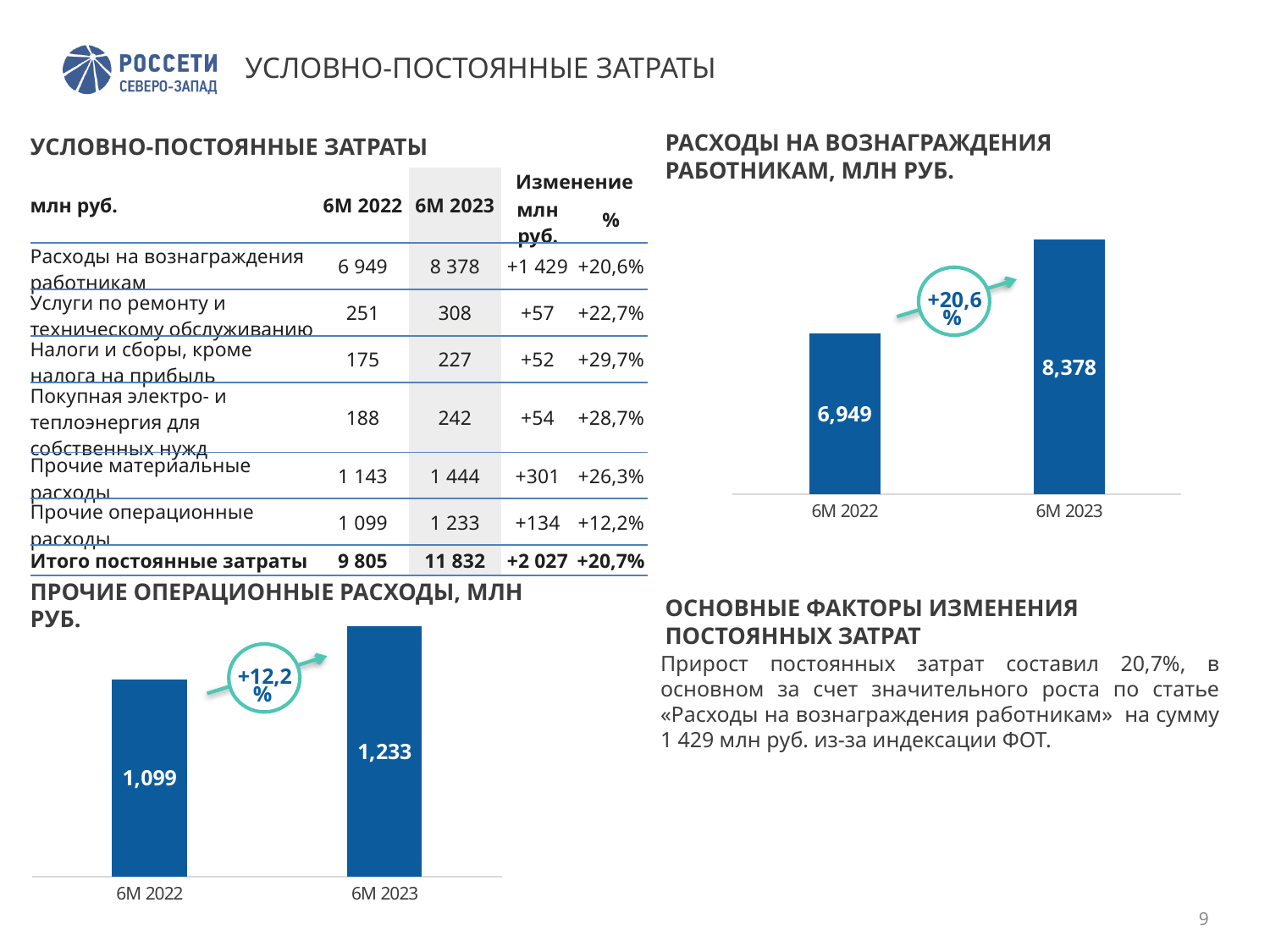
In the chart 'ПРОЧИЕ ОПЕРАЦИОННЫЕ РАСХОДЫ, МЛН РУБ.', what is the value for 6M 2023? 1,233 In the chart 'РАСХОДЫ НА ВОЗНАГРАЖДЕНИЯ РАБОТНИКАМ, МЛН РУБ.', what is the value for 6M 2023? 8,378 In the chart 'ПРОЧИЕ ОПЕРАЦИОННЫЕ РАСХОДЫ, МЛН РУБ.', do the values rise or fall from 6M 2022 to 6M 2023? Rise In the chart 'РАСХОДЫ НА ВОЗНАГРАЖДЕНИЯ РАБОТНИКАМ, МЛН РУБ.', what is the value for 6M 2022? 6,949 In the chart 'ПРОЧИЕ ОПЕРАЦИОННЫЕ РАСХОДЫ, МЛН РУБ.', how many bars are plotted? 2 In the chart 'РАСХОДЫ НА ВОЗНАГРАЖДЕНИЯ РАБОТНИКАМ, МЛН РУБ.', what is the difference between the 6M 2023 and 6M 2022 values? 1,429 In the chart 'РАСХОДЫ НА ВОЗНАГРАЖДЕНИЯ РАБОТНИКАМ, МЛН РУБ.', what percentage change is shown between 6M 2022 and 6M 2023? +20,6% In the chart 'ПРОЧИЕ ОПЕРАЦИОННЫЕ РАСХОДЫ, МЛН РУБ.', which period has the lower value? 6M 2022 What type of chart is 'РАСХОДЫ НА ВОЗНАГРАЖДЕНИЯ РАБОТНИКАМ, МЛН РУБ.'? Bar chart In the chart 'РАСХОДЫ НА ВОЗНАГРАЖДЕНИЯ РАБОТНИКАМ, МЛН РУБ.', which period has the higher value? 6M 2023 In the chart 'ПРОЧИЕ ОПЕРАЦИОННЫЕ РАСХОДЫ, МЛН РУБ.', what is the value for 6M 2022? 1,099 In the chart 'ПРОЧИЕ ОПЕРАЦИОННЫЕ РАСХОДЫ, МЛН РУБ.', what is the difference between the 6M 2023 and 6M 2022 values? 134